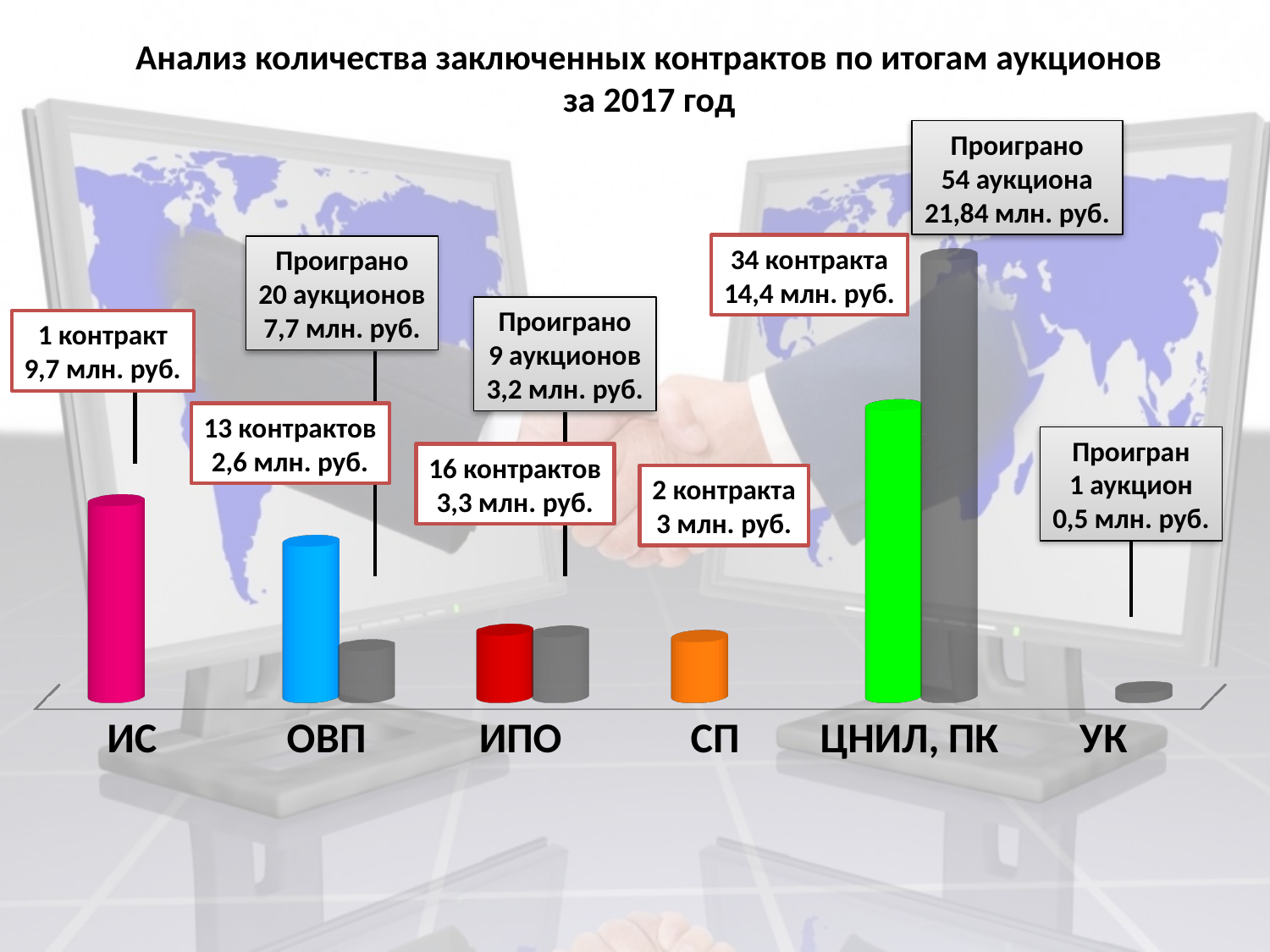
How many more auctions were lost for ЦНИЛ, ПК than for ОВП? 34 How many categories are shown along the x axis of the chart? 6 What is the value of the single contract concluded for ИС? 9,7 млн. руб. What kind of chart is shown on the slide? bar chart What is the title of the chart? Анализ количества заключенных контрактов по итогам аукционов за 2017 год Which category has the highest number of concluded contracts? ЦНИЛ, ПК How many contracts were concluded for ЦНИЛ, ПК according to the chart? 34 контракта What is the value of the lost auctions for ЦНИЛ, ПК? 21,84 млн. руб. How many auctions were lost for ОВП? 20 аукционов Which has more concluded contracts, ОВП or ИПО? ИПО What is the total value of contracts concluded for ИПО? 3,3 млн. руб.